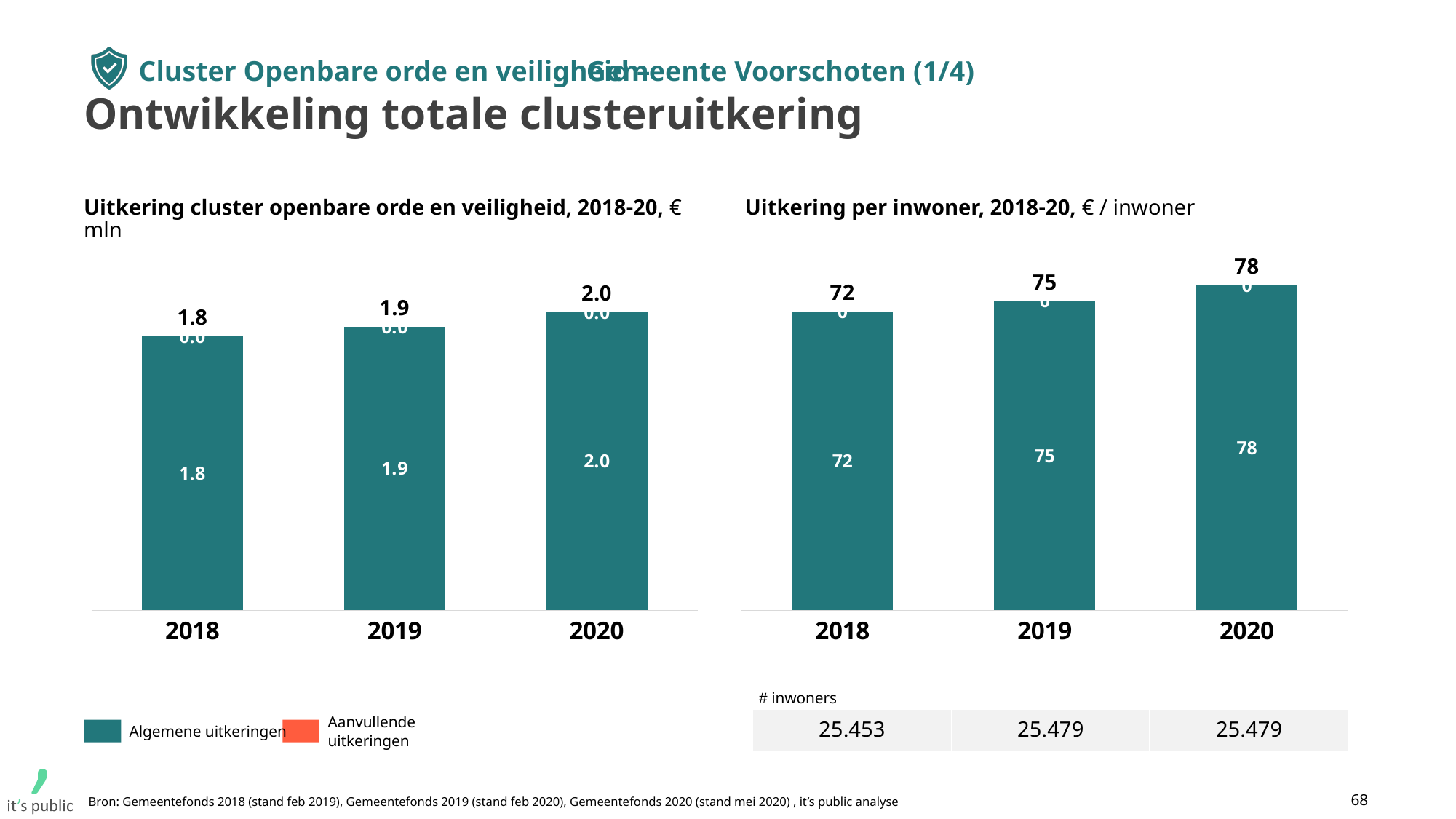
How many years are shown on the x axis of the left chart (Uitkering cluster openbare orde en veiligheid)? 3 In the left chart (Uitkering cluster openbare orde en veiligheid), which year has the lowest total? 2018 In the left chart (Uitkering cluster openbare orde en veiligheid), what is the difference between the 2020 and 2018 totals? 0.2 How many series does the legend on the slide list? 2 In the right chart (Uitkering per inwoner), do the values rise or fall from 2018 to 2020? Rise In the left chart (Uitkering cluster openbare orde en veiligheid), what is the total value for 2018? 1.8 In the right chart (Uitkering per inwoner), what is the value for 2019? 75 In the right chart (Uitkering per inwoner), what is the difference between the 2020 and 2018 values? 6 In the right chart (Uitkering per inwoner), which year has the highest value? 2020 In the left chart (Uitkering cluster openbare orde en veiligheid), what is the total value for 2020? 2.0 What kind of chart is the right chart (Uitkering per inwoner)? Bar chart In the right chart (Uitkering per inwoner), is the value for 2019 larger or smaller than the value for 2018? larger